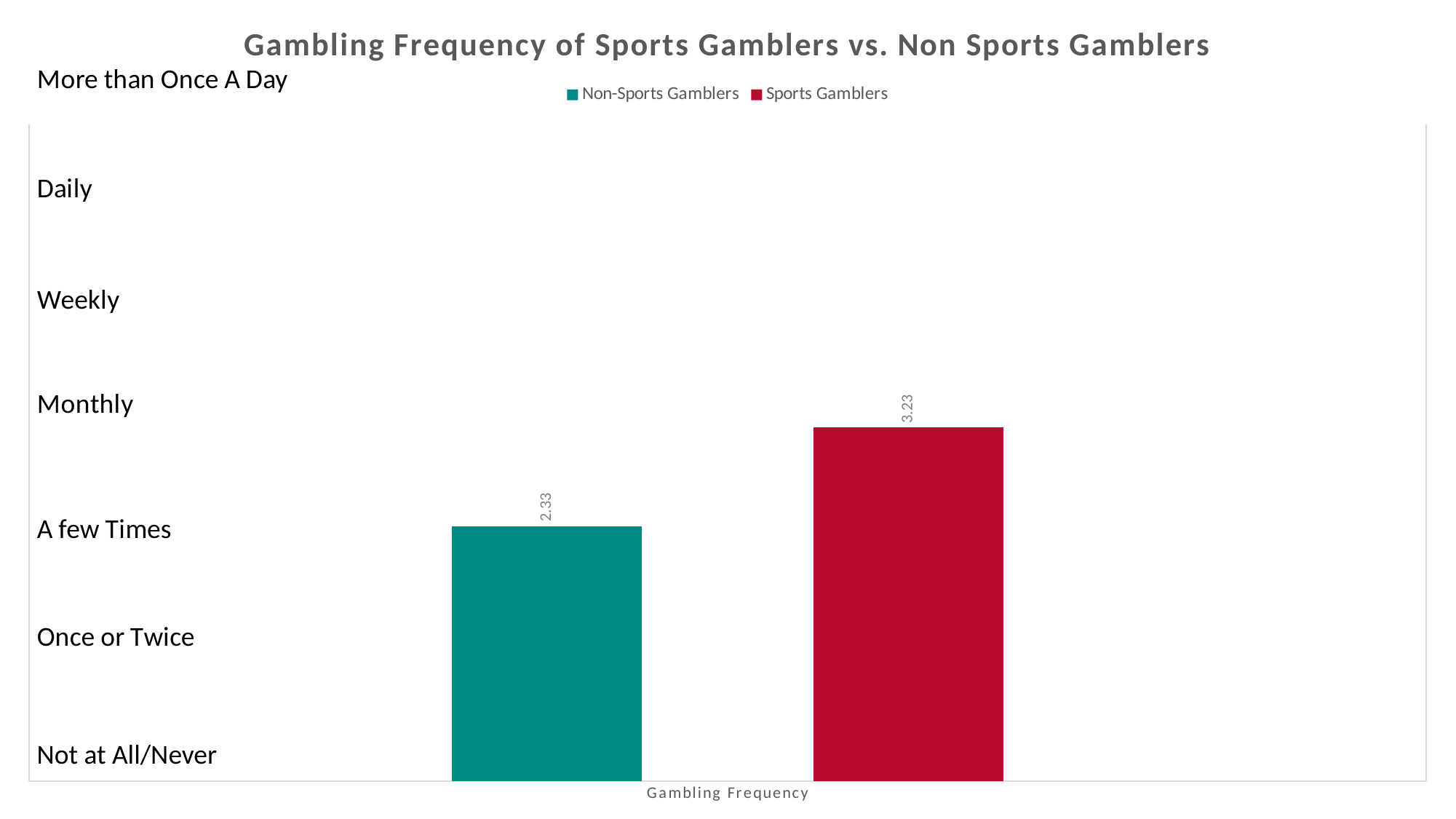
How many categories are shown on the x axis? 1 What is the label on the x axis? Gambling Frequency What is the title of the chart? Gambling Frequency of Sports Gamblers vs. Non Sports Gamblers Which series has the lowest value? Non-Sports Gamblers How many series does the legend list? 2 Which series has the highest value? Sports Gamblers What kind of chart is shown on the slide? Bar chart What colour is the bar for Sports Gamblers? Red Which series has the higher value, Non-Sports Gamblers or Sports Gamblers? Sports Gamblers What is the value for Sports Gamblers? 3.23 What is the value for Non-Sports Gamblers? 2.33 What is the difference between the Sports Gamblers value and the Non-Sports Gamblers value? 0.90